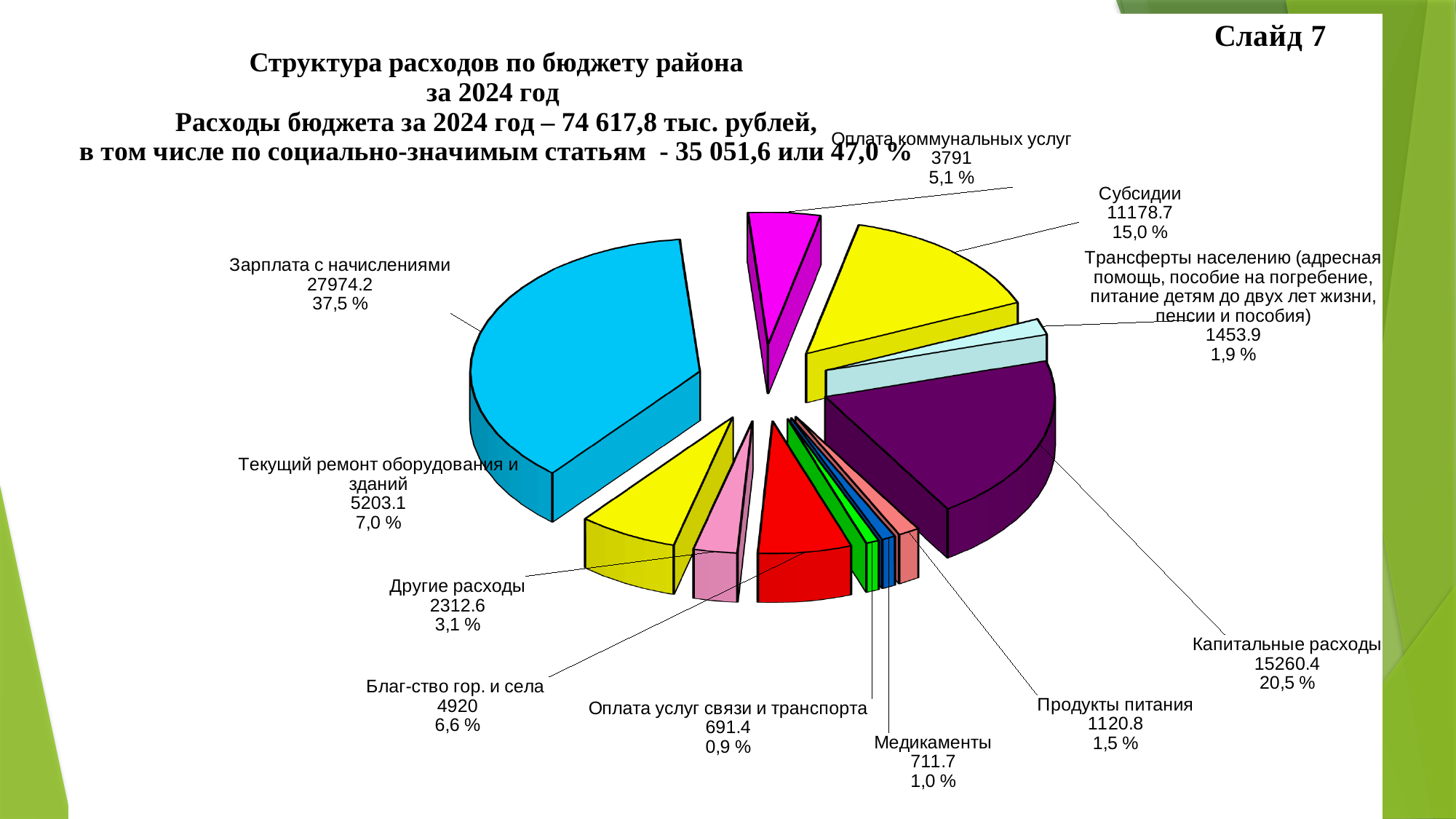
What type of chart is shown on the slide? pie chart What is the value shown for Субсидии? 11178.7 Which category has the smallest slice of the pie? Оплата услуг связи и транспорта What percentage is shown for Медикаменты? 1,0 % What is the difference between the values for Капитальные расходы and Субсидии? 4081.7 What is the title of the chart? Структура расходов по бюджету района за 2024 год What is the value shown for Зарплата с начислениями? 27974.2 Which is larger, the value for Благ-ство гор. и села or the value for Текущий ремонт оборудования и зданий? Текущий ремонт оборудования и зданий What share of the pie does Капитальные расходы represent? 20,5 % Which category has the largest slice of the pie? Зарплата с начислениями What is the value shown for Продукты питания? 1120.8 How many categories are shown in the pie chart? 11